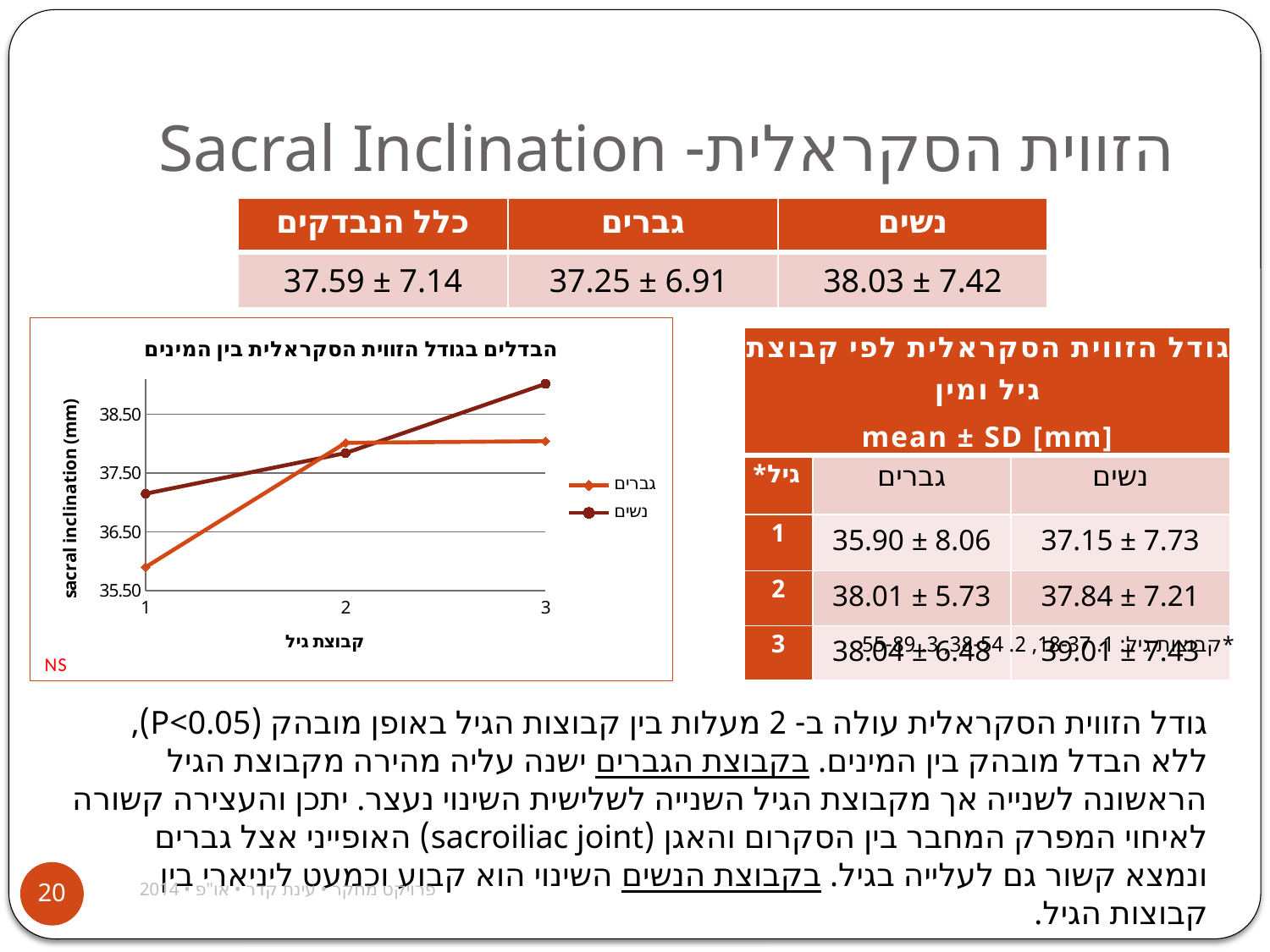
Is the value for גברים at age group 3 greater or less than 37.50? greater What kind of chart is shown on the slide? line chart How many series does the chart legend list? 2 Is the value for נשים at age group 3 greater or less than 38.50? greater For the נשים series, do the values rise or fall from age group 1 to age group 3? rise At age group 1, which series has the higher value, גברים or נשים? נשים At age group 3, which series has the higher value, גברים or נשים? נשים How many age groups are plotted along the x axis of the chart? 3 At which age group is the נשים series at its highest? 3 Is the value for גברים at age group 1 greater or less than 36.50? less What is the label of the chart's x axis? קבוצת גיל